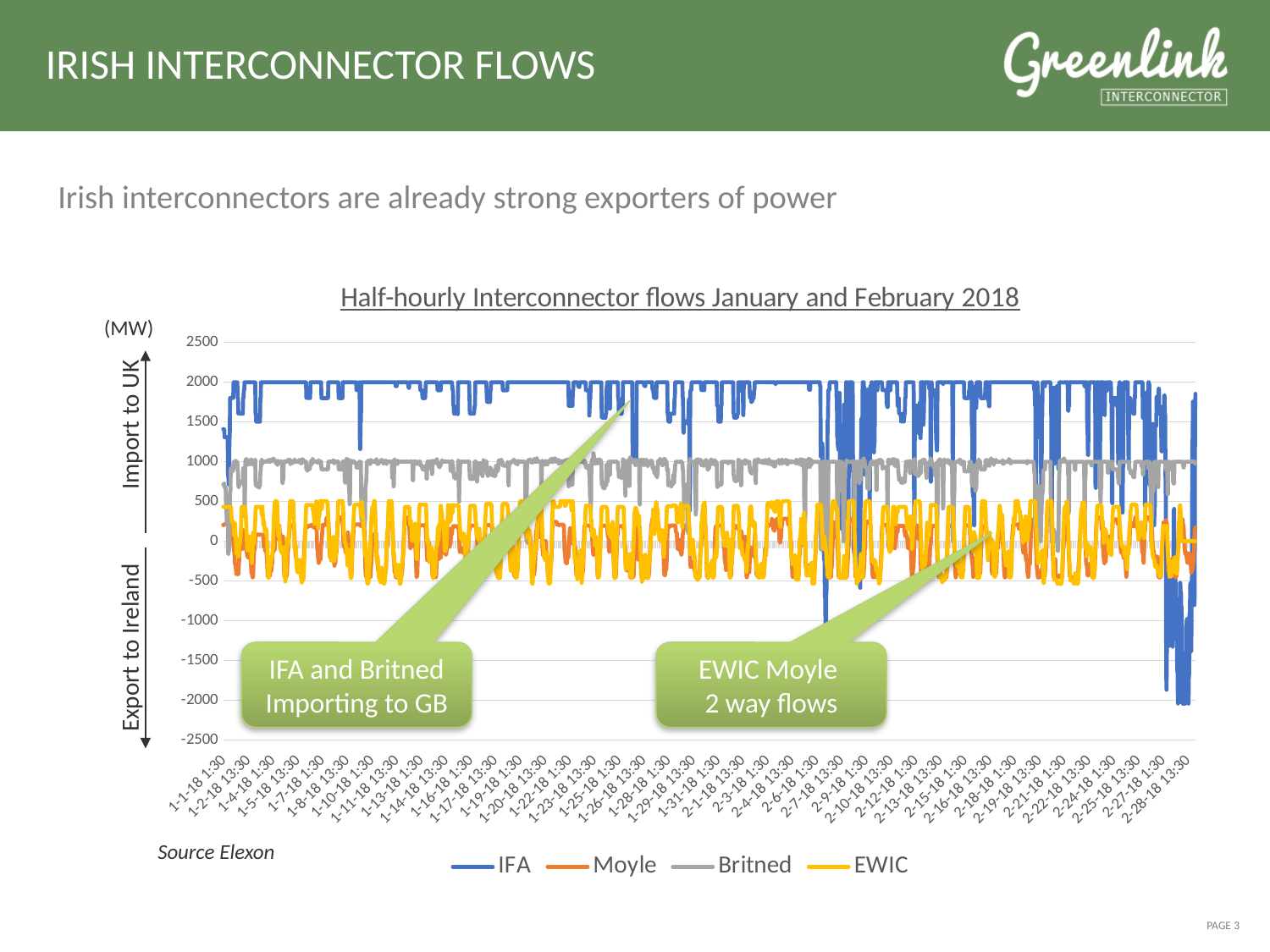
What is the title of the chart? Half-hourly Interconnector flows January and February 2018 How many series does the chart legend list? 4 Which series reaches the lowest (most negative) values on the chart? IFA Is the highest value reached by IFA greater or less than 1500? greater Is the highest value reached by Britned greater or less than 1500? less What kind of chart is shown on the slide? Line chart During early January, which series has larger values, IFA or Britned? IFA Is the lowest value reached by IFA greater or less than -1500? less Which colour is used for the IFA series in the chart? Blue Which series reaches the highest values on the chart? IFA What is the maximum value shown on the chart's vertical axis? 2500